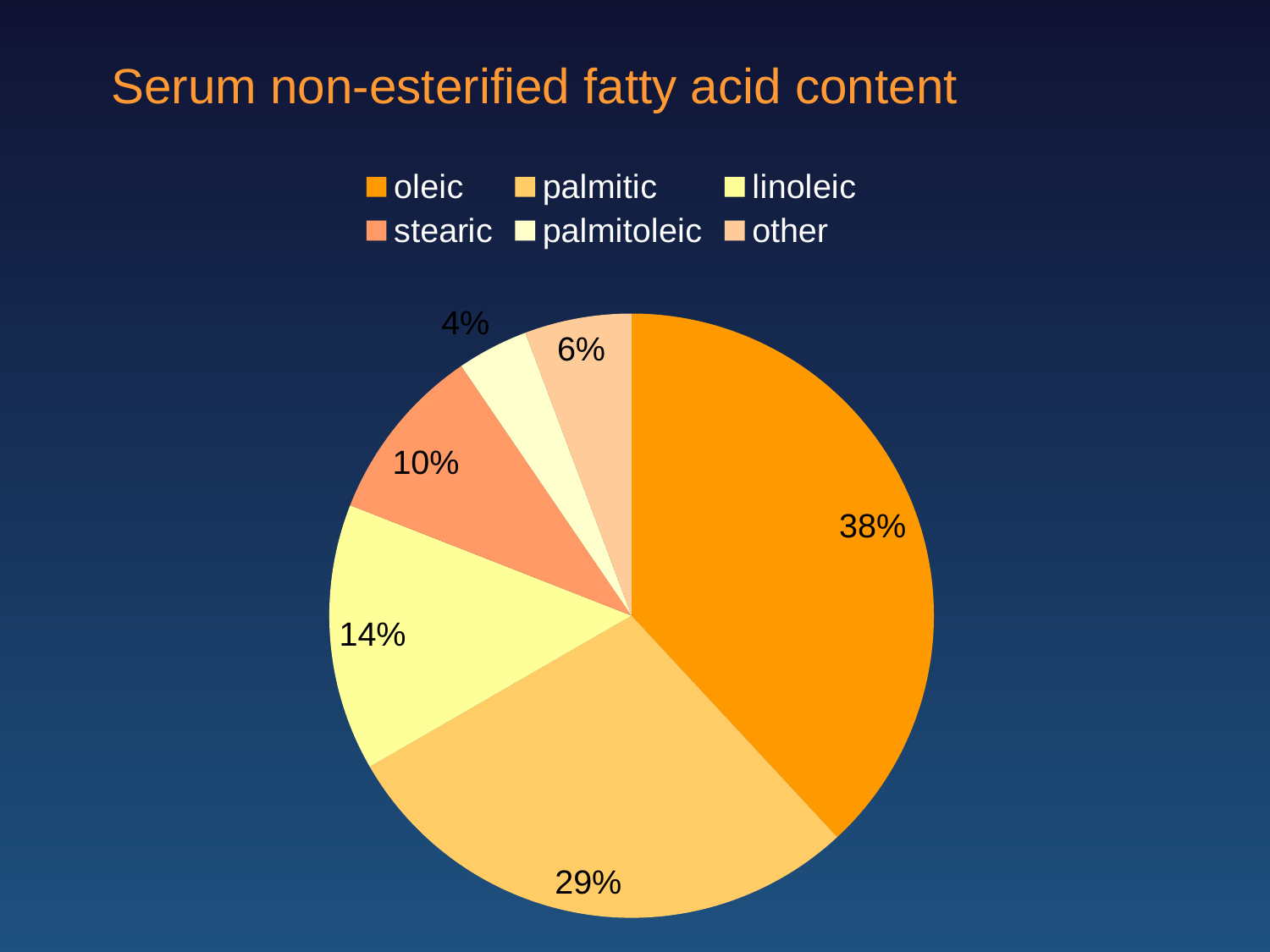
What is the difference in percentage points between the oleic and palmitic shares? 9 What share of the pie does palmitoleic acid account for? 4% How many categories does the legend list? 6 What kind of chart is shown on the slide? pie chart What share of the pie does palmitic acid account for? 29% Which fatty acid has the smallest share of the pie? palmitoleic What share of the pie does oleic acid account for? 38% Which has the larger share, linoleic or stearic? linoleic What is the title of the chart? Serum non-esterified fatty acid content Which fatty acid has the largest share of the pie? oleic